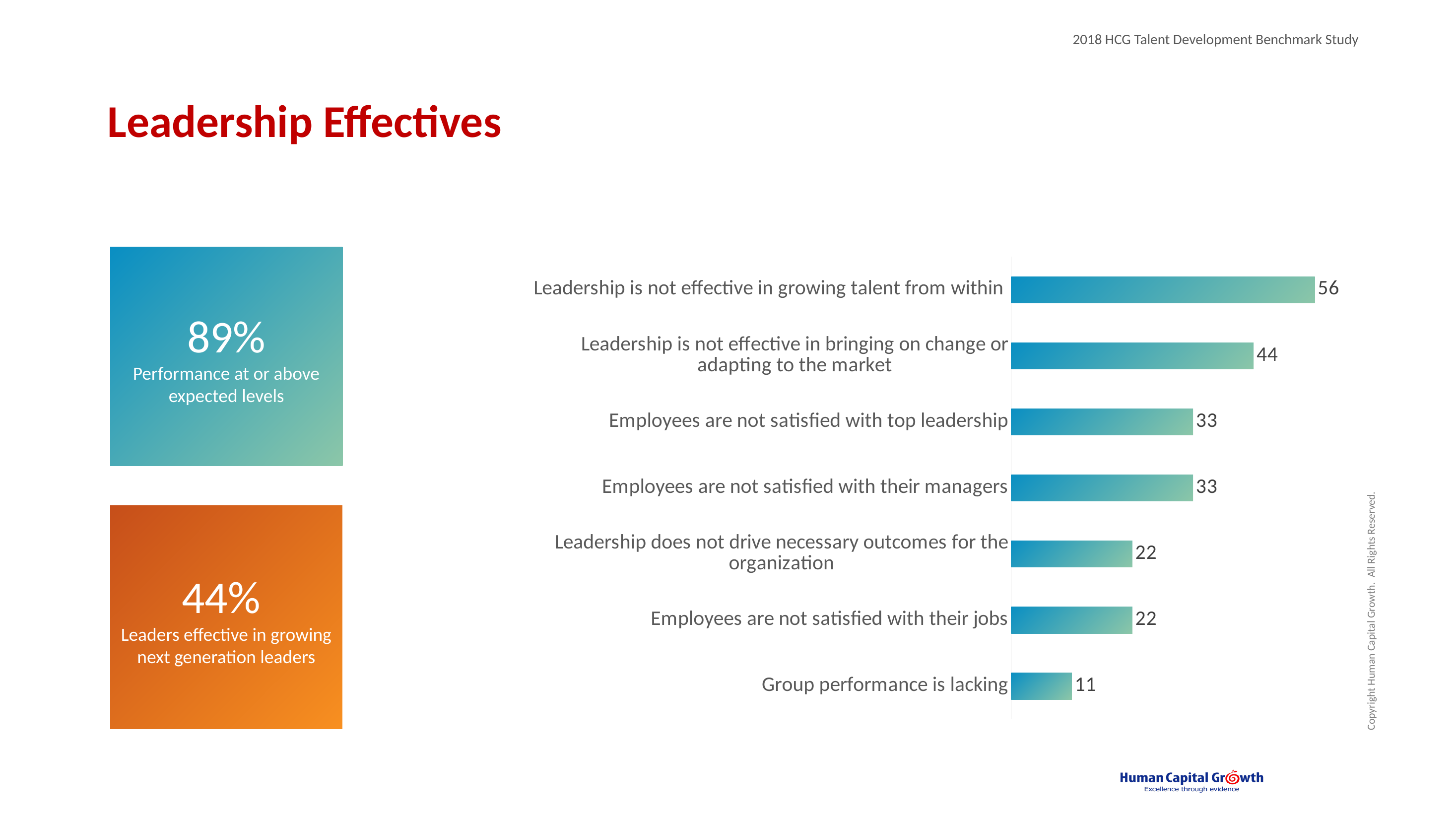
What is the difference between the values for "Employees are not satisfied with their managers" and "Group performance is lacking"? 22 What is the value for "Leadership is not effective in growing talent from within"? 56 Which category has the lowest value? Group performance is lacking Which category has the highest value? Leadership is not effective in growing talent from within What is the value for "Employees are not satisfied with top leadership"? 33 What is the difference between the values for "Leadership is not effective in growing talent from within" and "Leadership is not effective in bringing on change or adapting to the market"? 12 How many categories are shown in the bar chart? 7 What percentage is shown in the orange box on the left of the slide? 44% Which is larger: the value for "Employees are not satisfied with top leadership" or the value for "Employees are not satisfied with their jobs"? Employees are not satisfied with top leadership What is the value for "Leadership is not effective in bringing on change or adapting to the market"? 44 What is the value for "Group performance is lacking"? 11 What kind of chart is shown on the slide? Bar chart